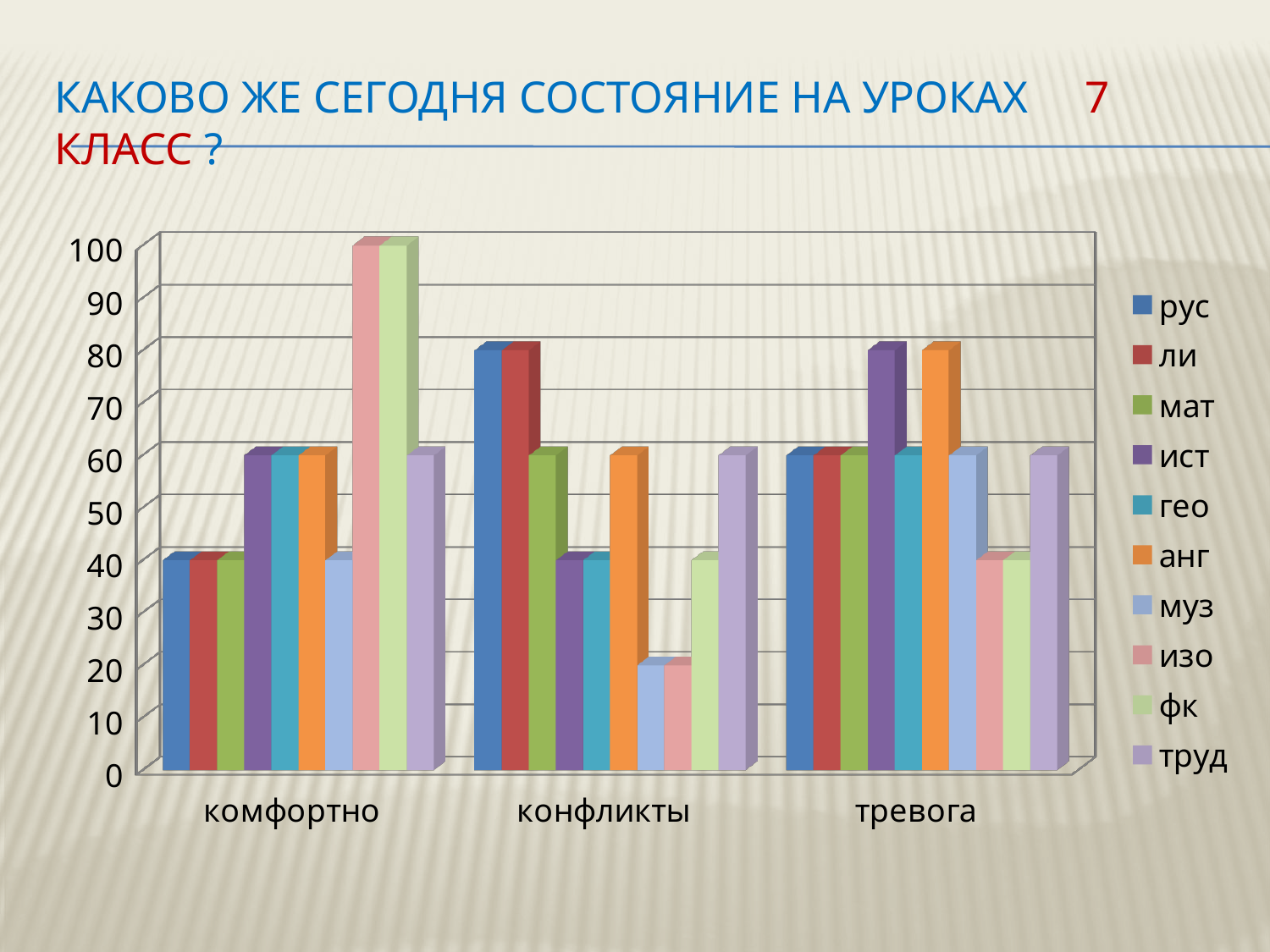
Which series is listed first in the chart legend? рус Is the value for муз in the конфликты category greater or less than 30? less In the комфортно category, which is larger: труд or муз? труд How many categories are shown along the x axis of the chart? 3 Is the value for ист in the тревога category greater or less than 70? greater What kind of chart is shown on the slide? bar chart What is the value for изо in the комфортно category? 100 Is the value for фк in the конфликты category greater or less than 50? less How many series does the chart legend list? 10 Which is larger for анг: the value in комфортно or the value in тревога? тревога Which is larger for рус: the value in комфортно or the value in конфликты? конфликты